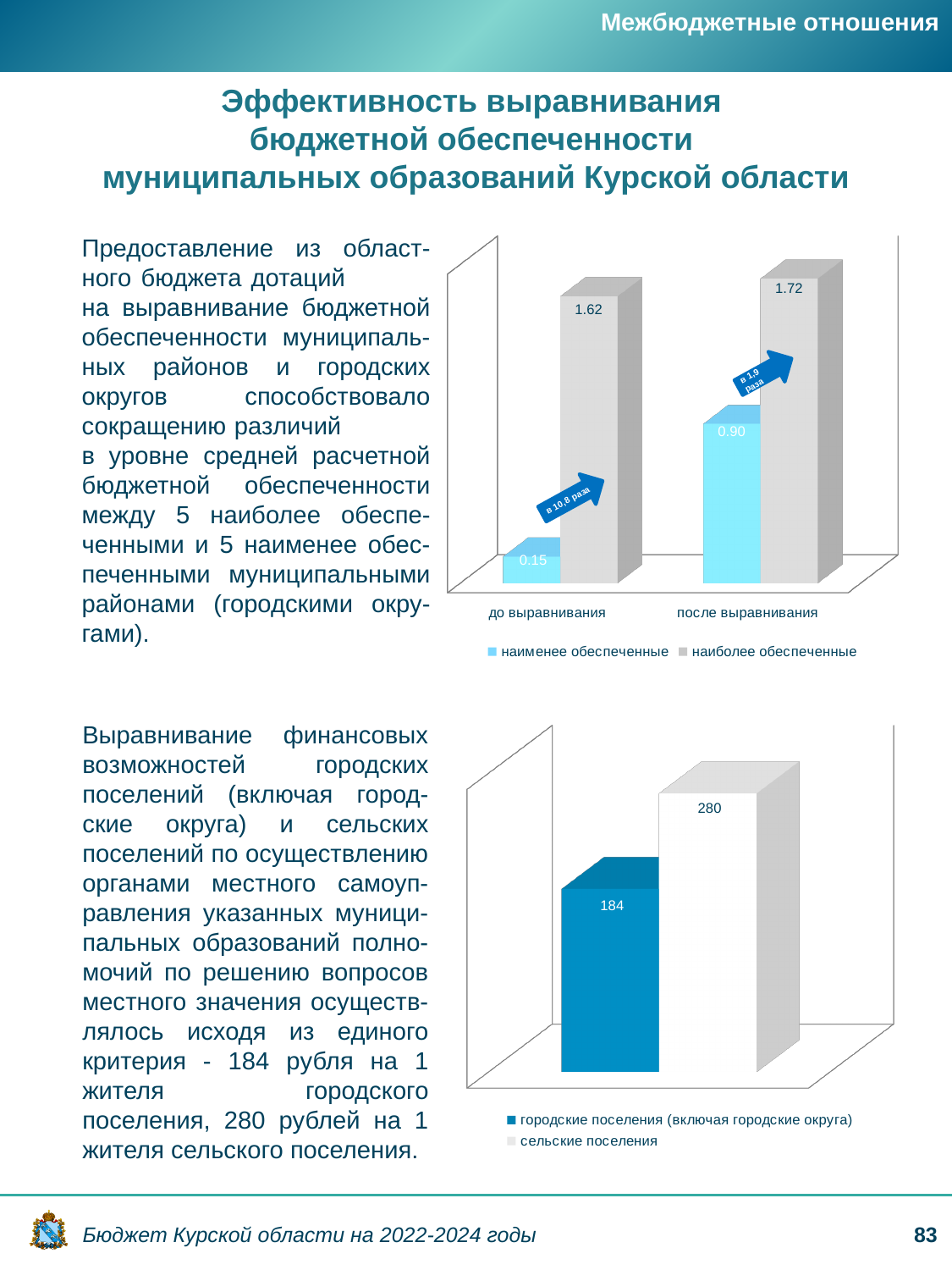
In the top chart, what is the value for 'наиболее обеспеченные' in the 'после выравнивания' category? 1.72 In the bottom chart, which category has the highest value? сельские поселения In the bottom chart, what is the value for 'сельские поселения'? 280 In the bottom chart, what is the value for 'городские поселения (включая городские округа)'? 184 In the top chart, how many series does the legend list? 2 In the bottom chart, what is the difference between 'сельские поселения' and 'городские поселения (включая городские округа)'? 96 In the top chart, does the value for 'наименее обеспеченные' rise or fall from 'до выравнивания' to 'после выравнивания'? rise In the top chart, what is the difference between 'наиболее обеспеченные' and 'наименее обеспеченные' in the 'до выравнивания' category? 1.47 In the top chart, what is the value for 'наименее обеспеченные' after equalisation ('после выравнивания')? 0.90 What type of chart is the bottom chart? bar chart In the top chart, which series has the higher value in the 'после выравнивания' category? наиболее обеспеченные In the top chart, what is the value for 'наименее обеспеченные' in the 'до выравнивания' category? 0.15